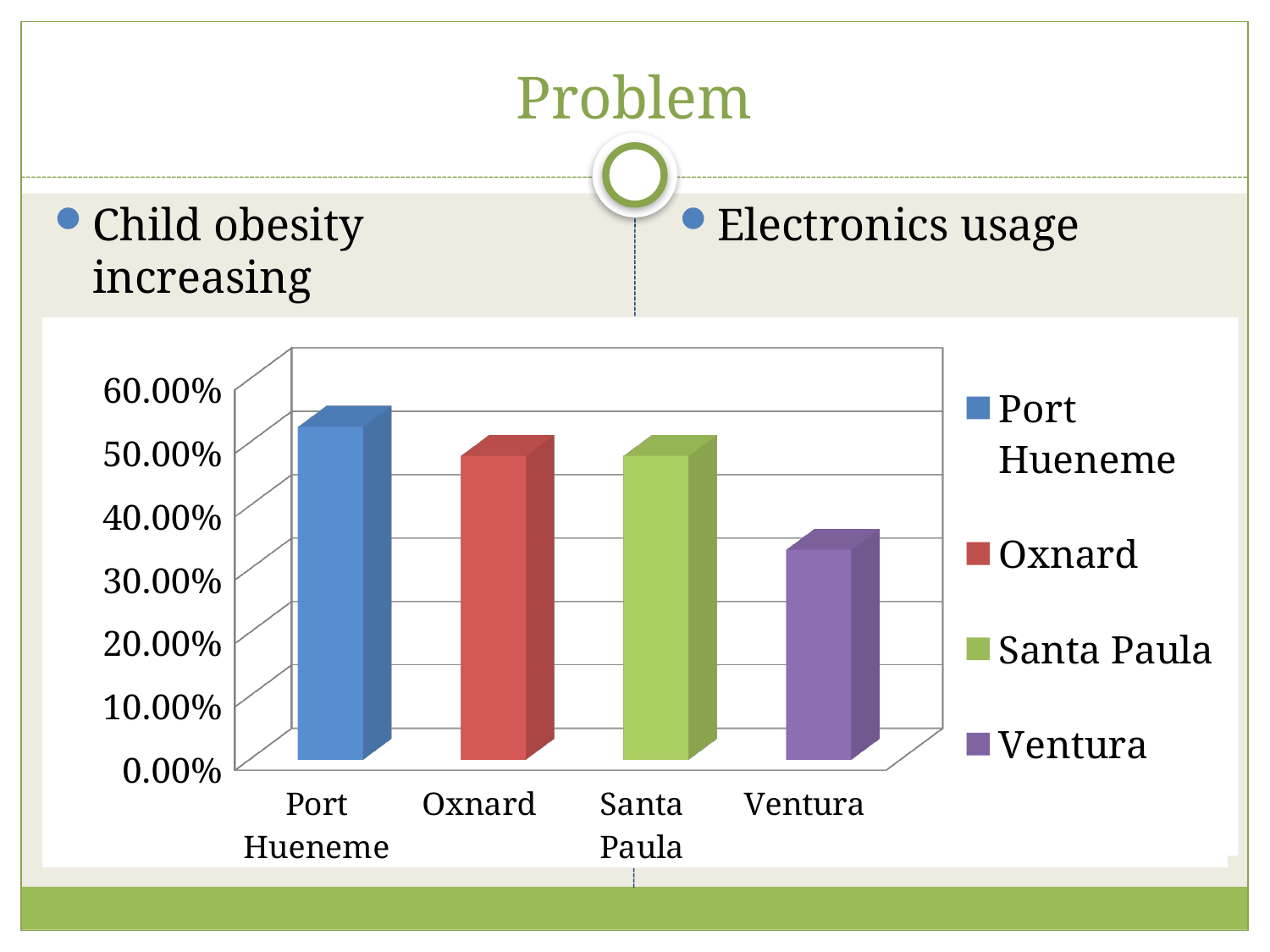
What colour is the bar for Ventura? Purple Is the value for Port Hueneme greater or less than 40.00%? greater Is the value for Ventura greater or less than 40.00%? less Which is larger, the value for Oxnard or the value for Ventura? Oxnard How many entries does the chart's legend list? 4 How many categories are plotted on the chart? 4 Which category has the highest value on the chart? Port Hueneme Which is larger, the value for Port Hueneme or the value for Ventura? Port Hueneme Which category has the lowest value on the chart? Ventura What kind of chart is shown on the slide? Bar chart Is the value for Ventura greater or less than 30.00%? greater